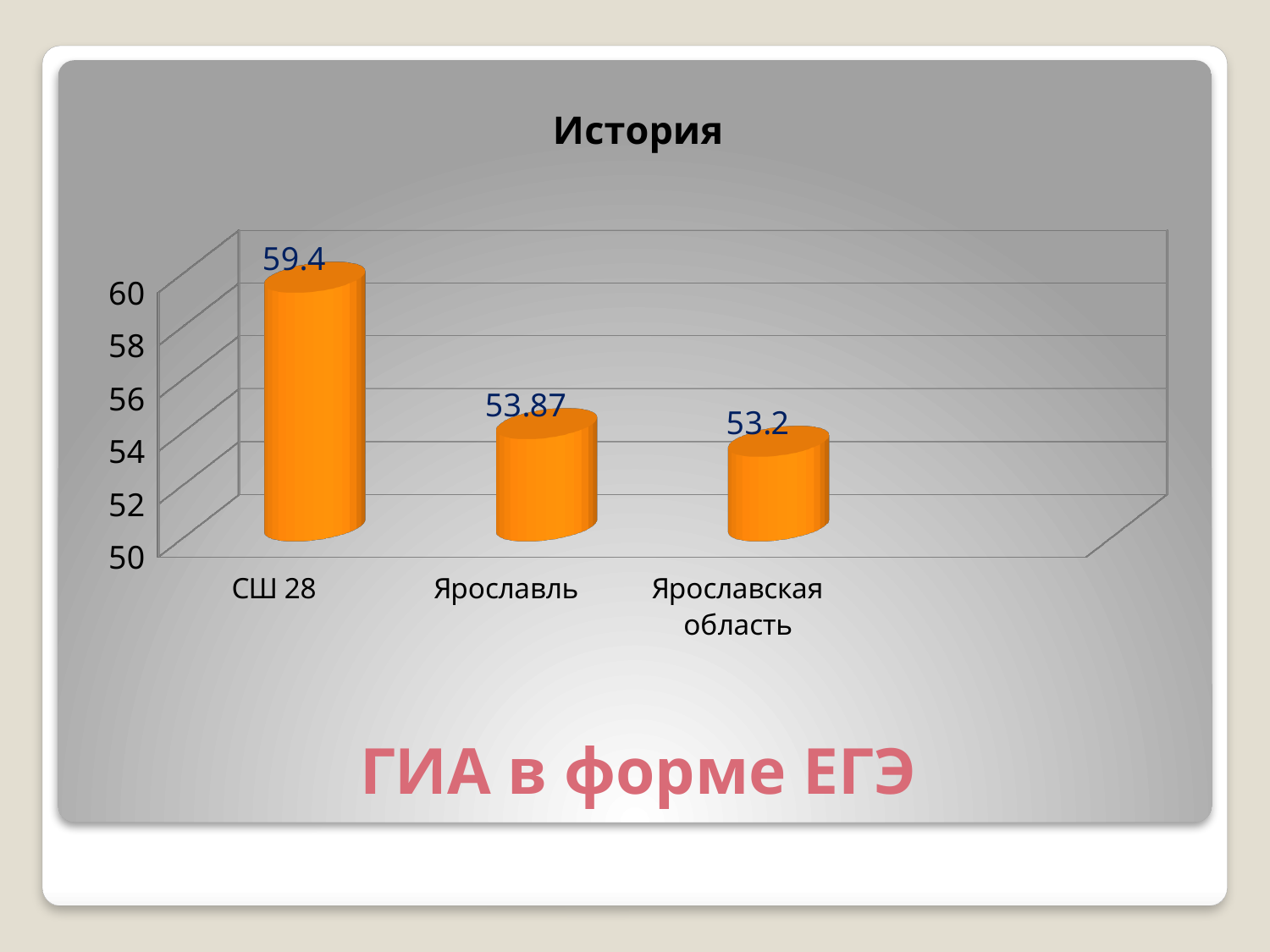
What is the difference between the values for СШ 28 and Ярославская область? 6.2 What is the value for Ярославль? 53.87 How many categories are shown in the chart? 3 What is the title of the chart? История Which category has the lowest value? Ярославская область What is the value for СШ 28? 59.4 What is the difference between the values for Ярославль and Ярославская область? 0.67 Which is larger, the value for СШ 28 or the value for Ярославль? СШ 28 Which category has the highest value? СШ 28 Is the value for Ярославль greater or less than 56? less What is the value for Ярославская область? 53.2 What kind of chart is shown on the slide? bar chart